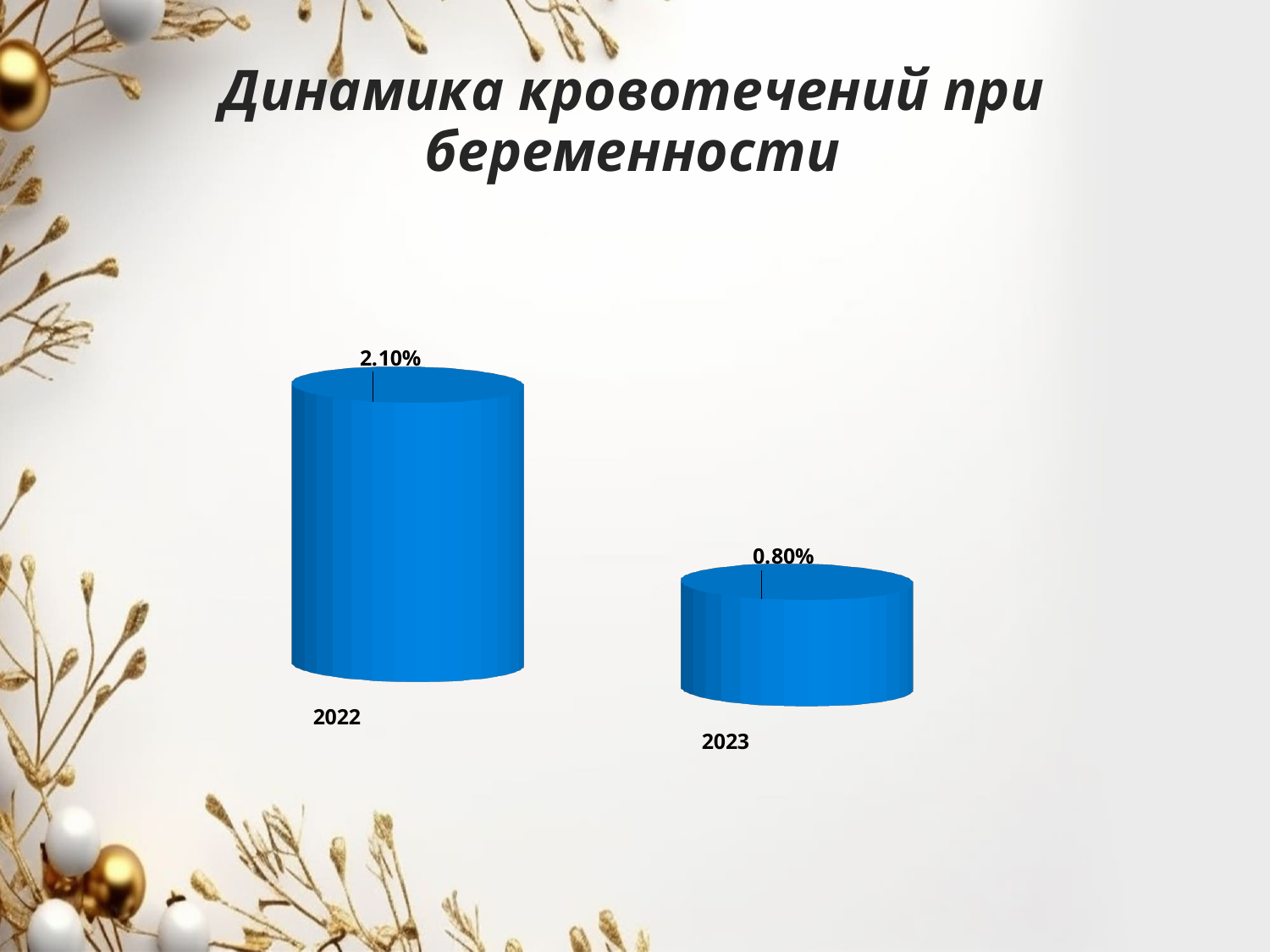
What is the value for 2023? 0.80% What is the title of the slide? Динамика кровотечений при беременности Which year has the lowest value? 2023 Do the values rise or fall from 2022 to 2023? Fall What is the difference between the values for 2022 and 2023? 1.30% What is the value for 2022? 2.10% What kind of chart is shown on the slide? Bar chart What colour are the bars in the chart? Blue How many categories are shown in the chart? 2 Which is larger, the value for 2022 or the value for 2023? 2022 Which year has the highest value? 2022